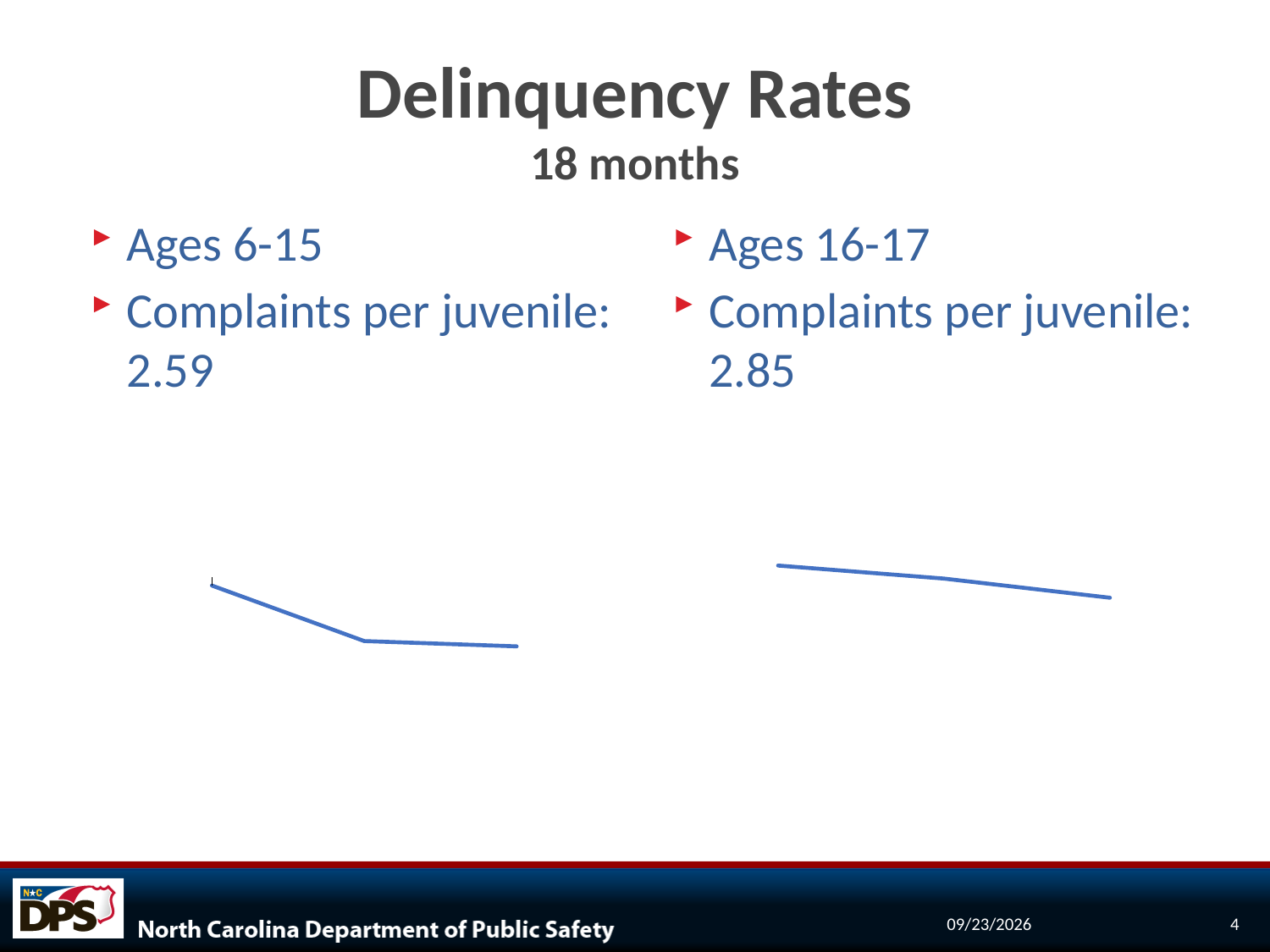
What kind of chart is shown on the right side of the slide, under "Ages 16-17"? line chart What kind of chart is shown on the left side of the slide, under "Ages 6-15"? line chart How many charts are shown on the slide? 2 In the right chart (under "Ages 16-17"), does the line rise or fall from left to right? fall What colour is the line in the left chart (under "Ages 6-15")? blue In the left chart (under "Ages 6-15"), does the line rise or fall from left to right? fall